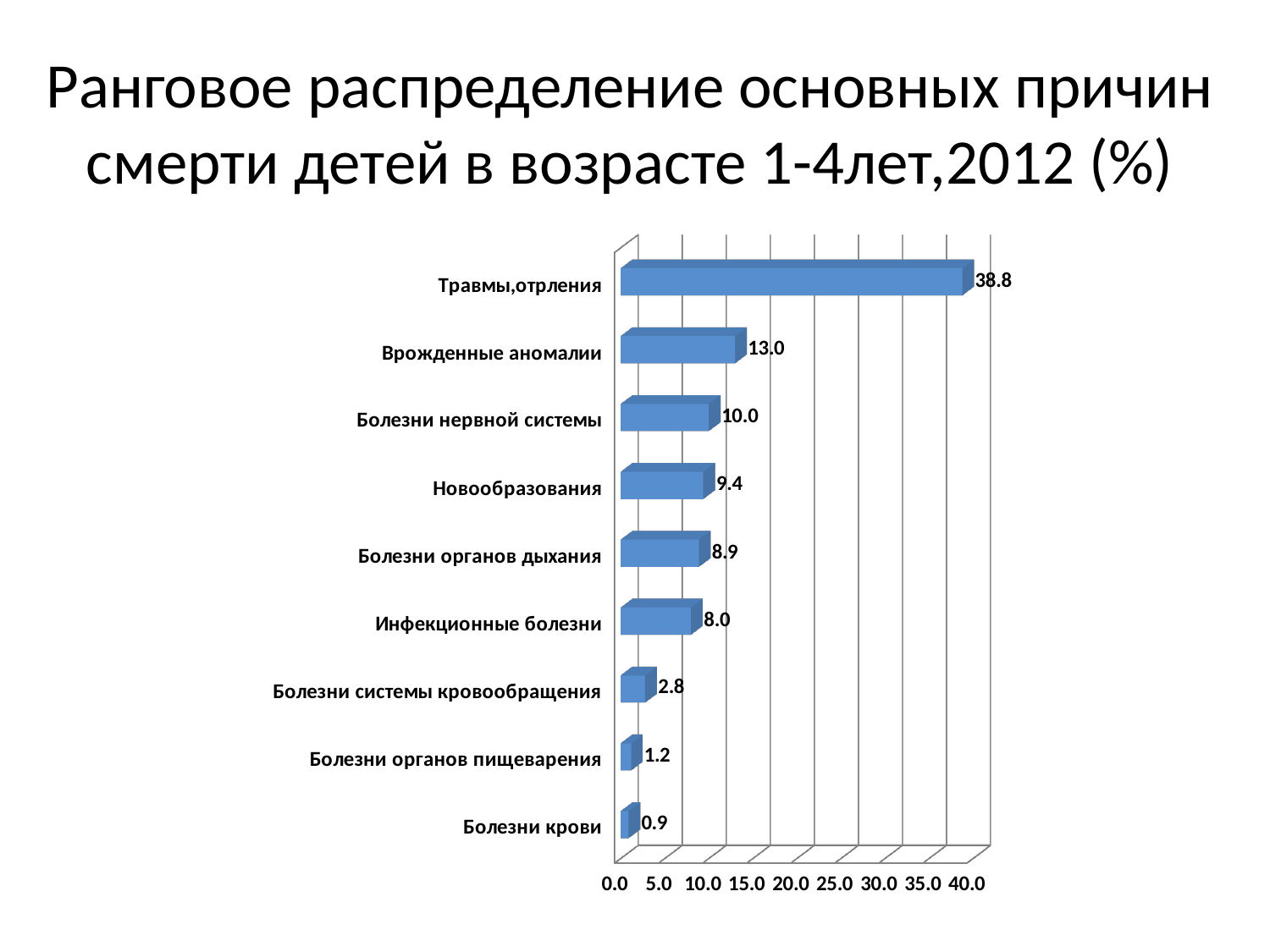
What is the difference between the values for Травмы,отрления and Врожденные аномалии? 25.8 Which is larger, the value for Новообразования or the value for Болезни системы кровообращения? Новообразования What is the value for Болезни органов дыхания? 8.9 Is the value for Врожденные аномалии greater or less than 10.0? greater What is the value for Врожденные аномалии? 13.0 What is the difference between the values for Болезни нервной системы and Инфекционные болезни? 2.0 Which category has the lowest value? Болезни крови What is the value for Травмы,отрления? 38.8 Which category has the highest value? Травмы,отрления What kind of chart is shown on the slide? bar chart What is the value for Болезни крови? 0.9 How many categories are shown in the chart? 9